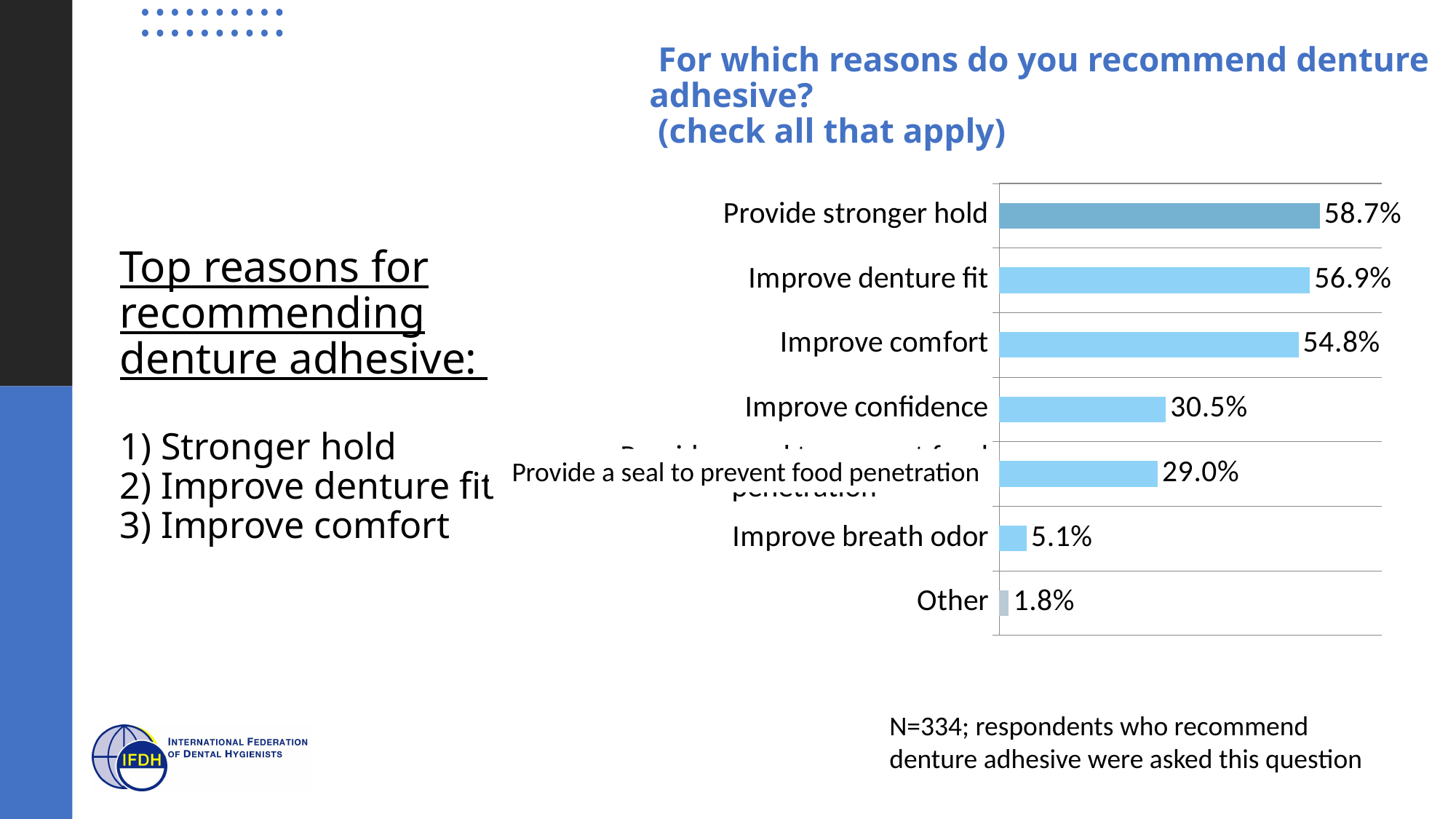
Which reason has the highest percentage in the chart? Provide stronger hold What type of chart is used on this slide? Bar chart What is the difference between "Improve comfort" and "Improve confidence"? 24.3% What is the value for "Provide a seal to prevent food penetration"? 29.0% How many reasons (categories) are shown in the chart? 7 Which is larger, the value for "Improve confidence" or the value for "Provide a seal to prevent food penetration"? Improve confidence According to the note below the chart, how many respondents were asked this question? N=334 What percentage is shown for "Improve breath odor"? 5.1% What is the value shown for "Improve confidence"? 30.5% Which category has the lowest percentage in the chart? Other What percentage of respondents selected "Provide stronger hold" as a reason for recommending denture adhesive? 58.7% What is the difference between the percentages for "Provide stronger hold" and "Improve denture fit"? 1.8%